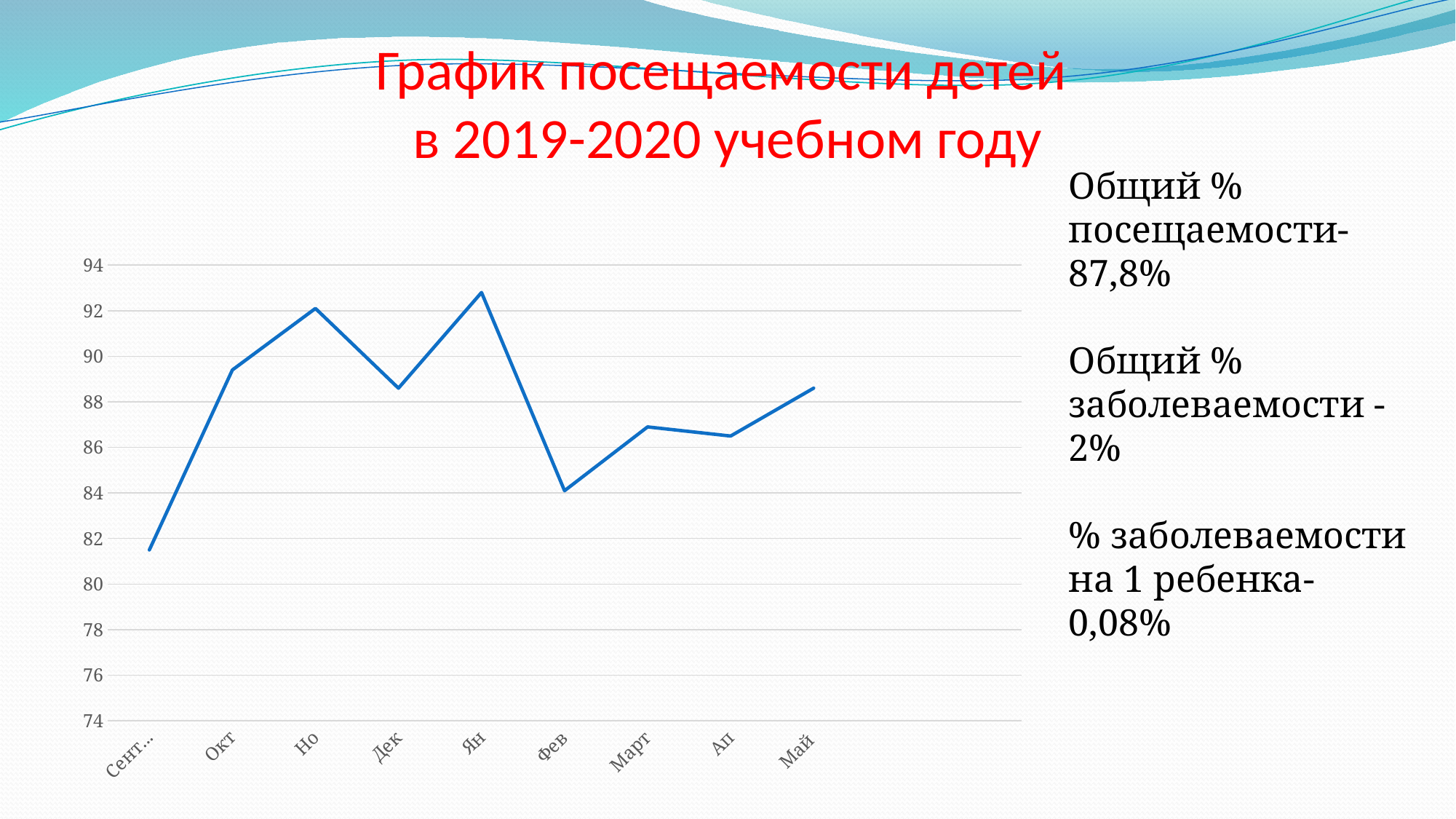
Is the value for Но greater or less than 90? greater What is the title of the slide containing the chart? График посещаемости детей в 2019-2020 учебном году Is the value for Фев greater or less than 86? less What kind of chart is shown on the slide? line chart How many months (data points) are plotted on the chart? 9 Which month has the lowest value on the chart? Сент... Does the line rise or fall from Ян to Фев? fall Which month has the highest value on the chart? Ян Is the value for Сент... greater or less than 82? less Which is larger, the value for Но or the value for Дек? Но Which is larger, the value for Окт or the value for Фев? Окт